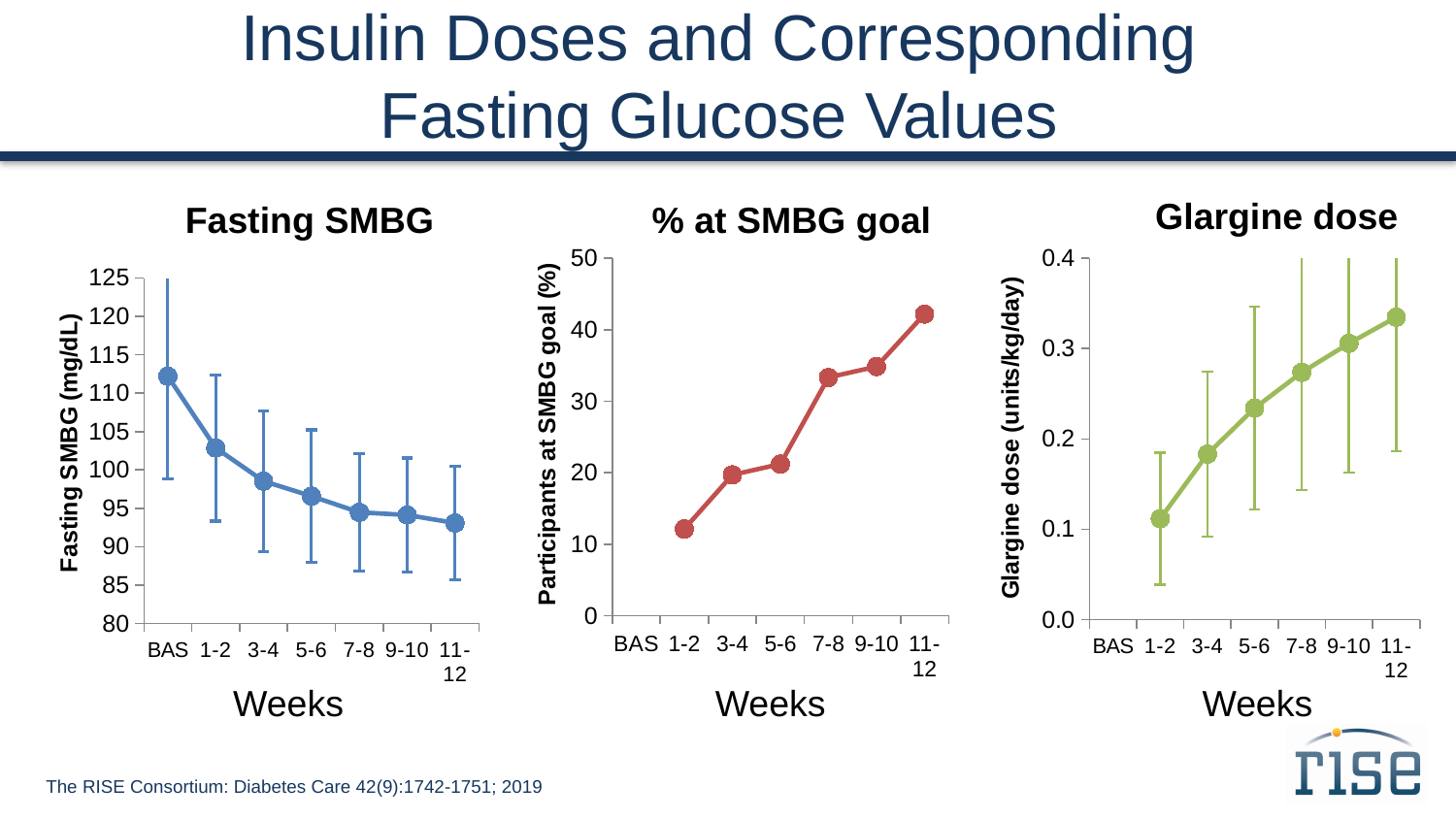
In the % at SMBG goal chart, which week category has the highest percentage of participants at goal? 11-12 In the Glargine dose chart, which week category has the highest glargine dose? 11-12 In the % at SMBG goal chart, is the value at weeks 11-12 greater or less than 40? greater In the Fasting SMBG chart, is the value at weeks 11-12 greater or less than 95? less In the Fasting SMBG chart, do the values rise or fall from BAS to weeks 11-12? fall In the Fasting SMBG chart, which week category has the highest fasting SMBG value? BAS In the Fasting SMBG chart, is the value at BAS greater or less than 110? greater What kind of chart is the Glargine dose chart? line chart In the % at SMBG goal chart, which week category has the lowest percentage of participants at goal? 1-2 In the Glargine dose chart, which is larger, the value at weeks 3-4 or the value at weeks 9-10? 9-10 In the % at SMBG goal chart, do the values rise or fall from weeks 1-2 to weeks 11-12? rise